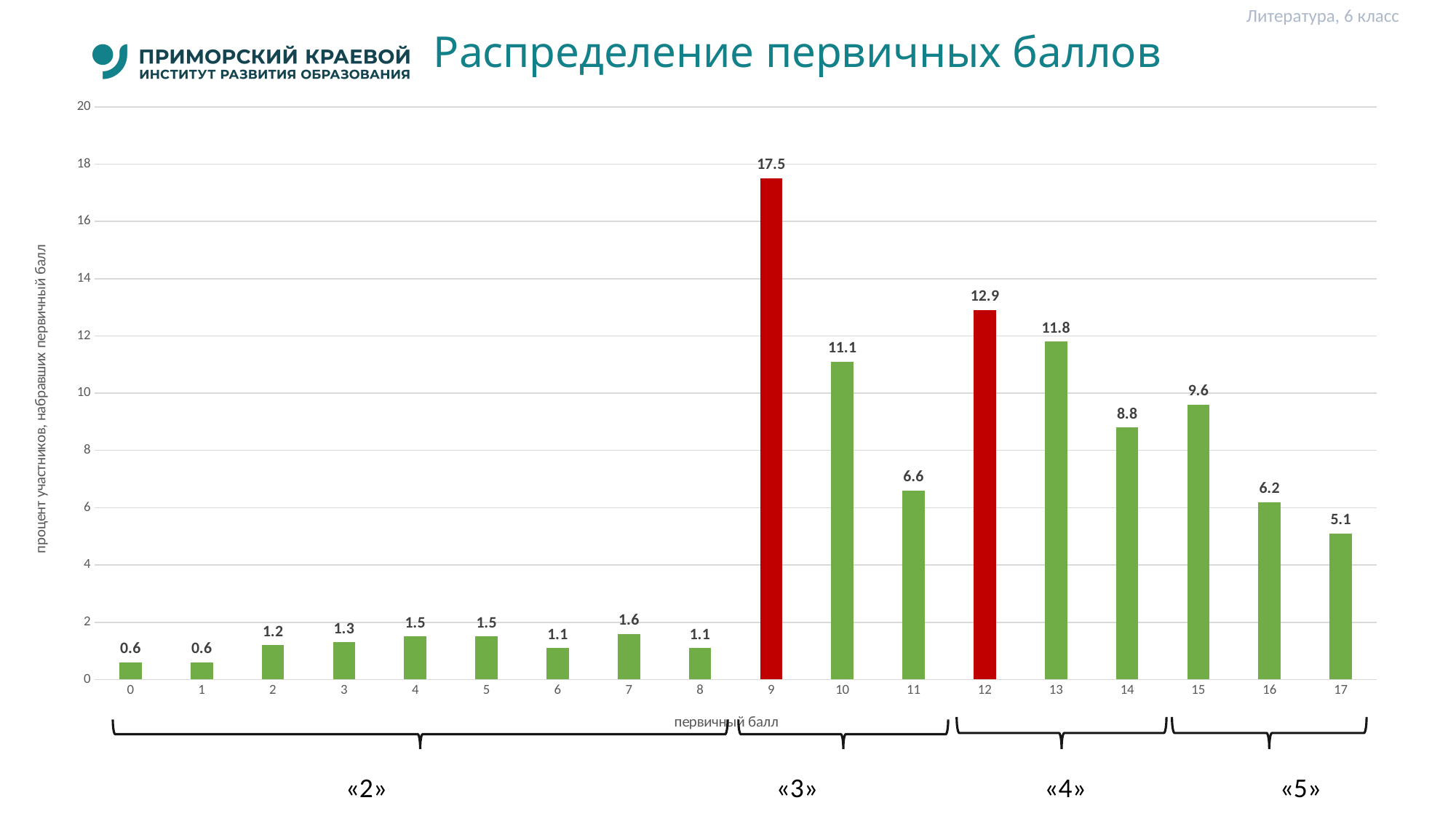
What is the value for primary score 9? 17.5 Which primary score has the highest value? 9 Which is larger, the value for primary score 10 or for primary score 13? 13 What is the value for primary score 17? 5.1 What is the value for primary score 12? 12.9 What is the difference between the values for primary scores 13 and 14? 3.0 What is the difference between the values for primary scores 9 and 12? 4.6 Is the value for primary score 15 greater or less than 8? greater What is the value for primary score 3? 1.3 What type of chart is shown on the slide? bar chart Which two bars are coloured red? 9 and 12 How many primary score categories are shown on the x axis? 18